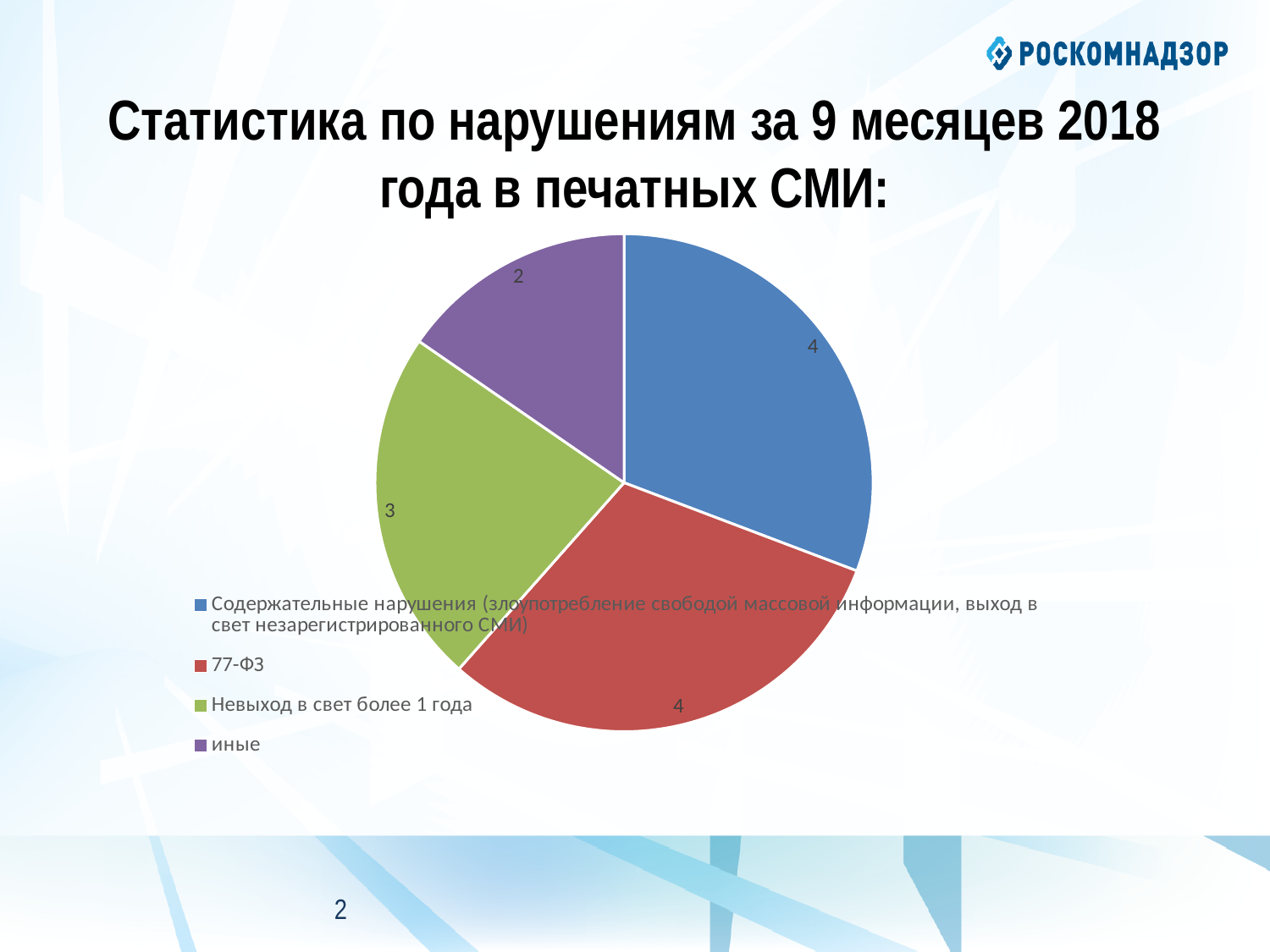
How many slices does the pie chart have? 4 What is the value for the slice "Содержательные нарушения (злоупотребление свободой массовой информации, выход в свет незарегистрированного СМИ)"? 4 Which category has the smallest slice in the pie chart? иные What is the difference between the value for "Невыход в свет более 1 года" and the value for "иные"? 1 What is the total of all the values shown in the pie chart? 13 What is the value for the slice "77-ФЗ"? 4 What is the value for the slice "Невыход в свет более 1 года"? 3 What kind of chart is shown on the slide? pie chart What colour is the slice for "Невыход в свет более 1 года"? green What is the value for the slice "иные"? 2 What is the difference between the value for "77-ФЗ" and the value for "иные"? 2 Which is larger: the value for "Невыход в свет более 1 года" or the value for "иные"? Невыход в свет более 1 года